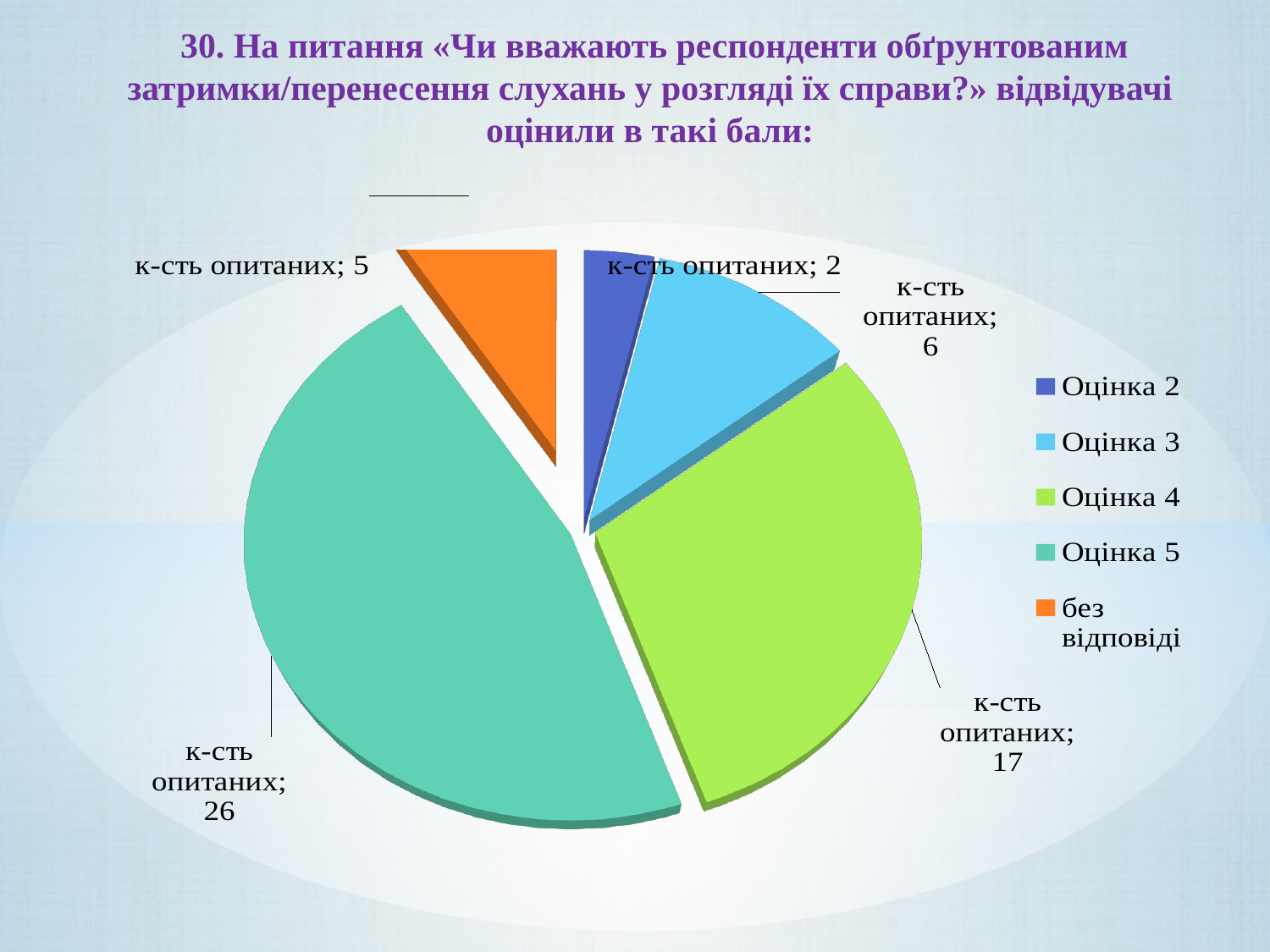
Which category has the smallest slice of the pie? Оцінка 2 Which is larger, the value for "Оцінка 3" or the value for "без відповіді"? Оцінка 3 What type of chart is shown on the slide? pie chart What is the total number of respondents across all slices of the pie? 56 How many respondents are in the "без відповіді" slice? 5 What colour is the "Оцінка 4" slice in the pie chart? green What is the value shown for "Оцінка 4"? 17 How many categories does the pie chart show? 5 What is the difference between the values for "Оцінка 5" and "Оцінка 4"? 9 What is the value for "Оцінка 2"? 2 Which category has the largest slice of the pie? Оцінка 5 How many respondents gave the rating "Оцінка 5"? 26